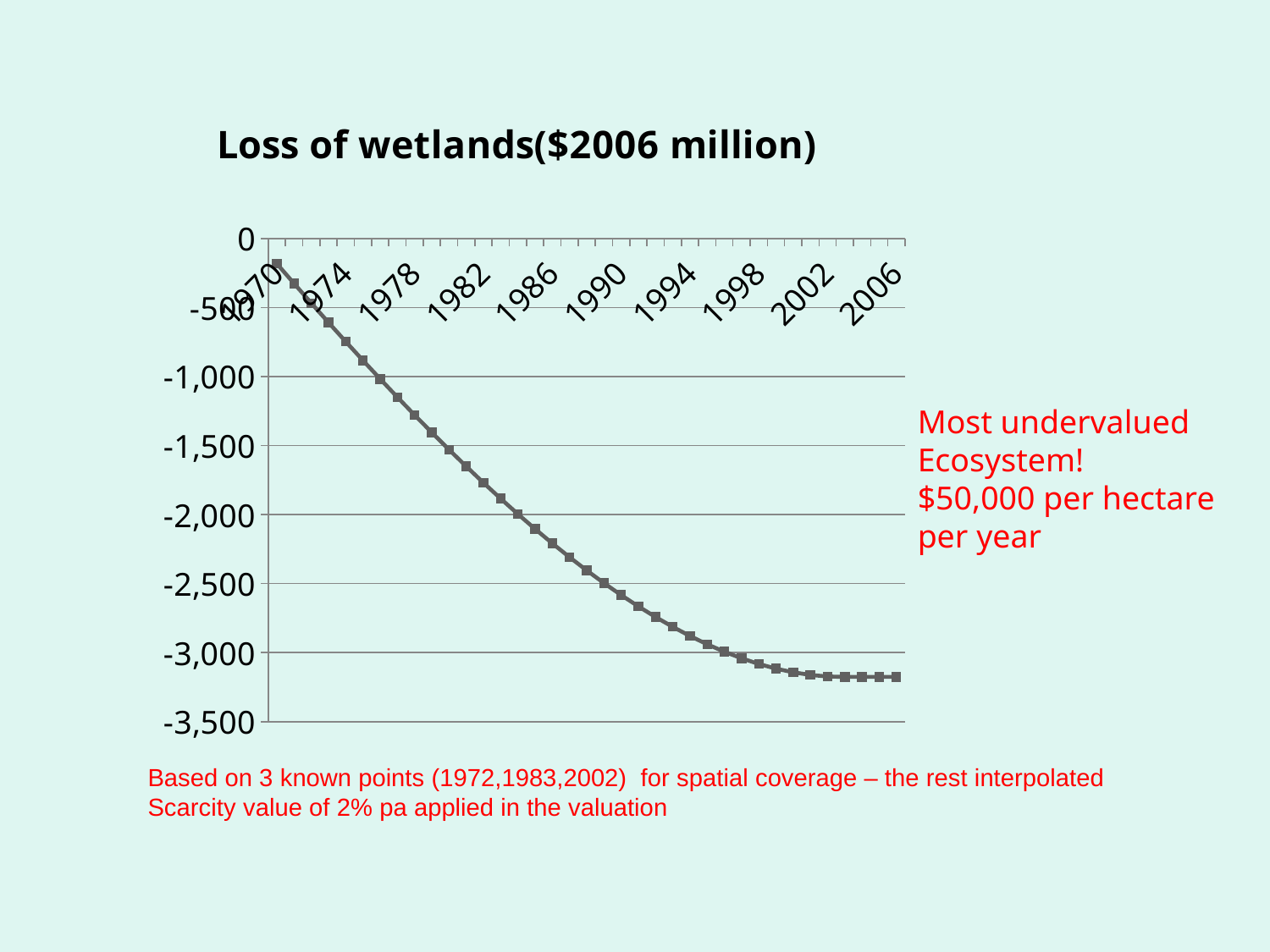
Is the value for 1982 greater or less than -1,500? less Is the value for 1978 greater or less than -1,000? less How many year labels are shown on the x axis? 10 Is the value for 2006 greater or less than -3,500? greater Do the plotted values rise or fall as the years increase from 1970 to 2006? fall Which year has the highest (least negative) value on the chart? 1970 What type of chart is shown on the slide? line chart Which year has the larger value, 1974 or 1994? 1974 What is the title of the chart? Loss of wetlands($2006 million) What is the lowest value shown on the y axis? -3,500